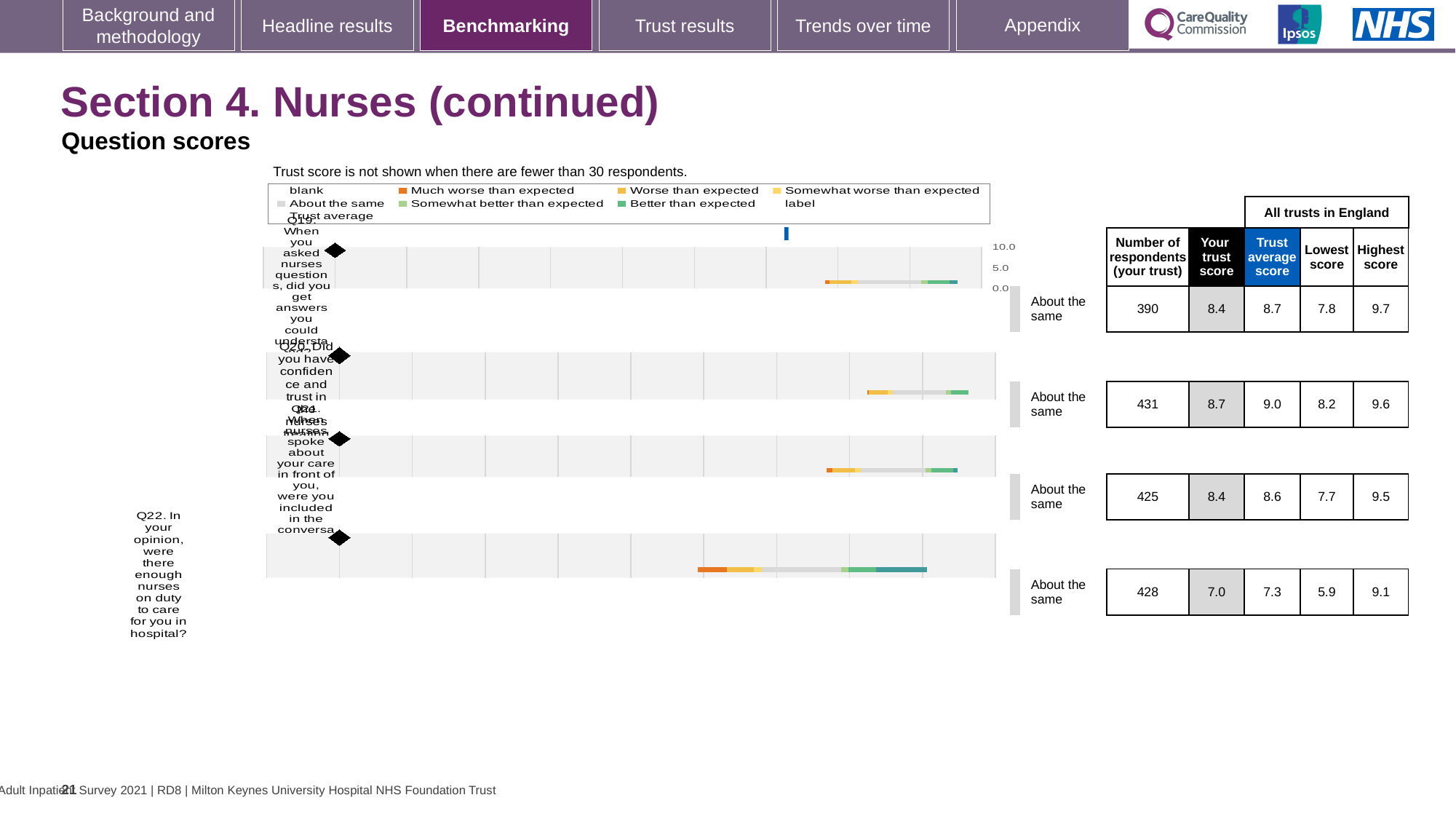
For Q21, which is larger: your trust score or the trust average score? Trust average score Which question has the highest 'Your trust score'? Q20 What kind of chart is used to show the question scores on this slide? bar chart For Q22, what is the difference between the highest score and the lowest score across all trusts in England? 3.2 Which question has the lowest 'Your trust score'? Q22 What is the 'Your trust score' for Q22 (enough nurses on duty)? 7.0 How many questions (categories) are plotted in the chart? 4 What is the number of respondents for Q20 (confidence and trust in nurses)? 431 What benchmark category is shown for Q19? About the same What is the lowest score across all trusts in England for Q21? 7.7 What is the trust average score for Q19 (answers you could understand)? 8.7 According to the note above the chart, when is the trust score not shown? When there are fewer than 30 respondents